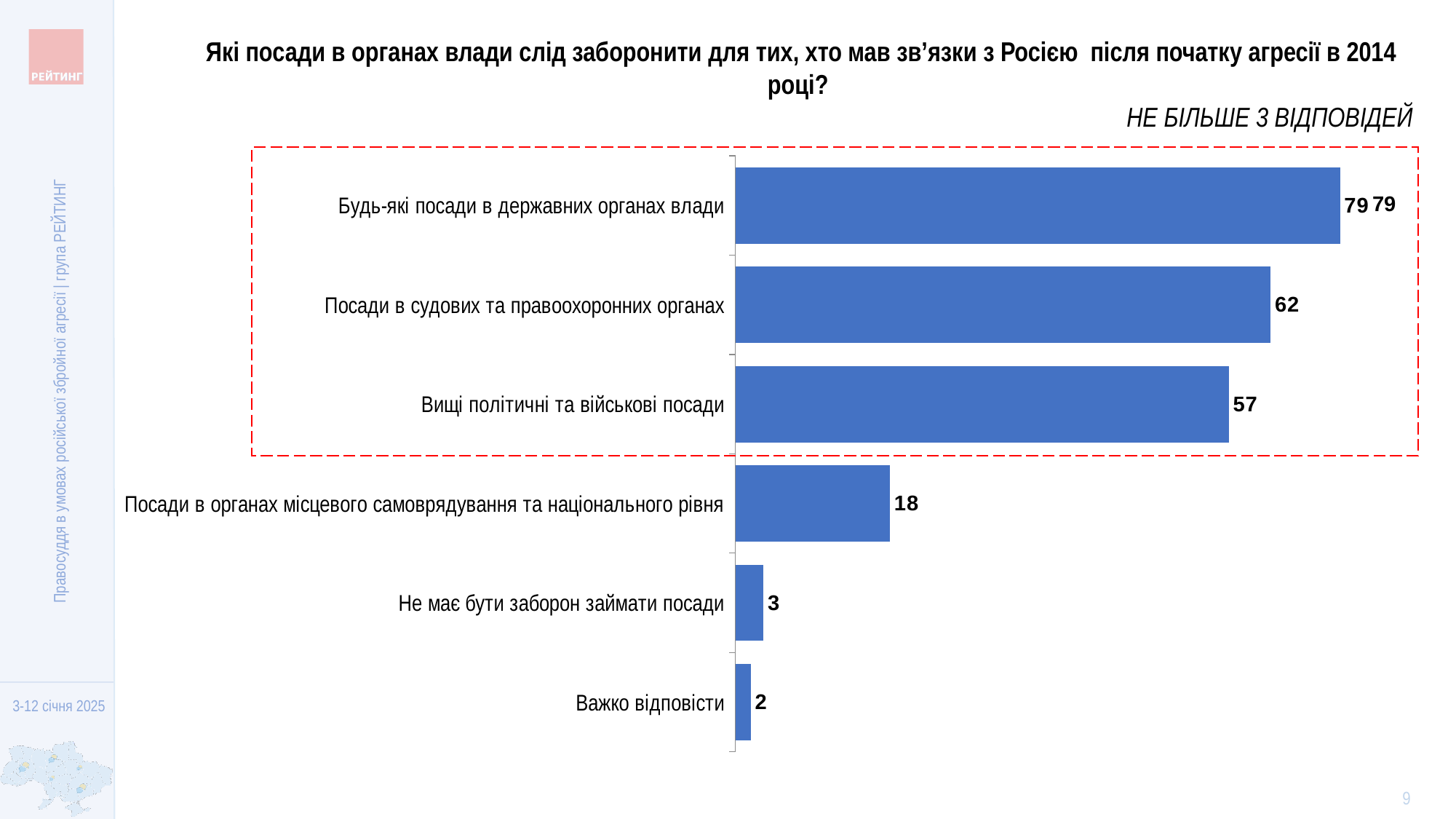
What is the value for "Не має бути заборон займати посади"? 3 What is the value for "Посади в судових та правоохоронних органах"? 62 What kind of chart is shown on the slide? Bar chart What is the difference between the values for "Посади в судових та правоохоронних органах" and "Вищі політичні та військові посади"? 5 Which category has the highest value? Будь-які посади в державних органах влади What is the value for "Вищі політичні та військові посади"? 57 Which is larger: the value for "Посади в органах місцевого самоврядування та національного рівня" or the value for "Не має бути заборон займати посади"? Посади в органах місцевого самоврядування та національного рівня How many categories are enclosed by the red dashed box? 3 Which category has the lowest value? Важко відповісти What is the value for "Будь-які посади в державних органах влади"? 79 What is the value for "Посади в органах місцевого самоврядування та національного рівня"? 18 How many categories are shown in the chart? 6